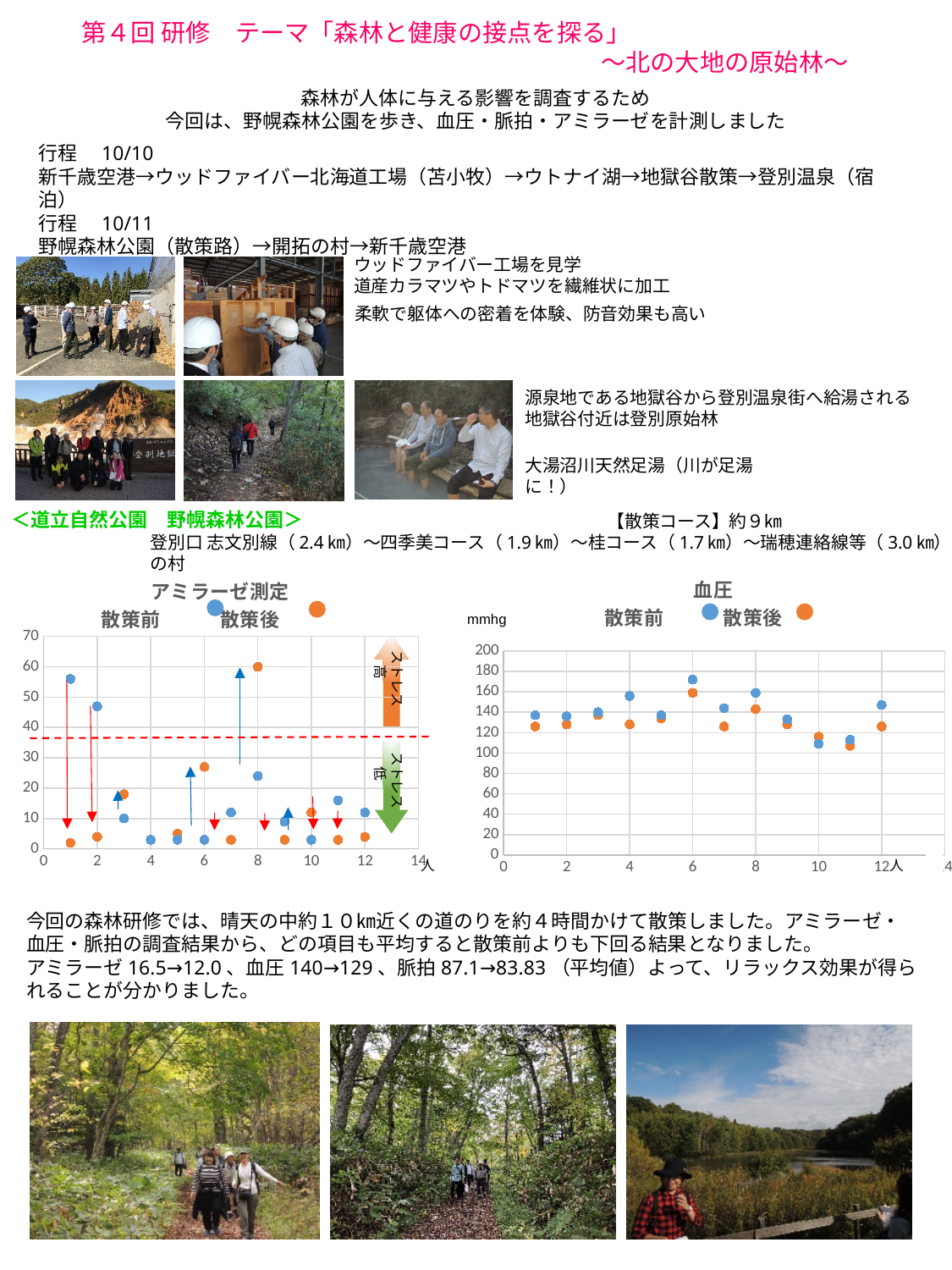
What unit is written at the top of the y axis of the 血圧 chart? mmhg In the アミラーゼ測定 chart, is the 散策後 value for person 1 greater or less than 10? less In the 血圧 chart, is the 散策前 value for person 10 greater or less than 120? less What are the two legend entries of the 血圧 chart? 散策前, 散策後 In the アミラーゼ測定 chart, is the 散策前 value for person 1 greater or less than 50? greater In the 血圧 chart, which person has the highest 散策前 value? 6 What kind of chart is the 血圧 chart? scatter chart In the アミラーゼ測定 chart, which is larger for person 2, the 散策前 value or the 散策後 value? 散策前 How many series does the legend of the アミラーゼ測定 chart list? 2 In the 血圧 chart, how many people are plotted for the 散策前 series? 12 In the アミラーゼ測定 chart, which person has the highest 散策後 value? 8